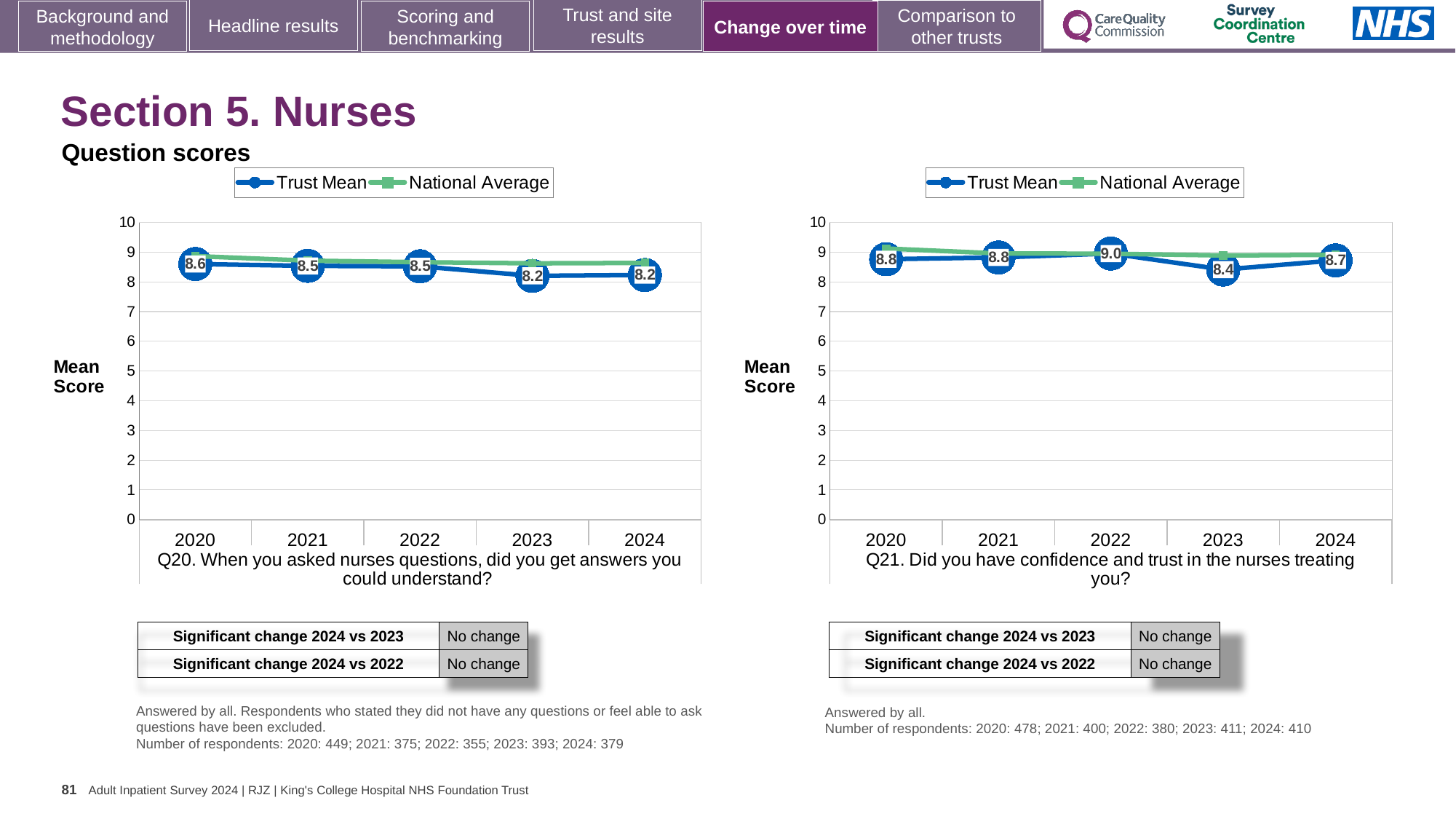
In the Q21 chart, what is the Trust Mean score for 2023? 8.4 In the Q20 chart, what is the Trust Mean score for 2020? 8.6 In the Q21 chart, which year has the lowest Trust Mean score? 2023 What kind of chart is the Q20 chart? Line chart In the Q20 chart, what is the Trust Mean score for 2024? 8.2 How many years are plotted on the x axis of the Q20 chart? 5 In the Q21 chart, what is the Trust Mean score for 2022? 9.0 In the Q21 chart, is the Trust Mean score for 2024 greater or less than the Trust Mean score for 2023? greater In the Q20 chart, what is the difference between the Trust Mean scores for 2020 and 2024? 0.4 In the Q21 chart, which year has the highest Trust Mean score? 2022 In the Q21 chart, what is the difference between the Trust Mean scores for 2022 and 2023? 0.6 How many series does the legend of the Q21 chart list? 2